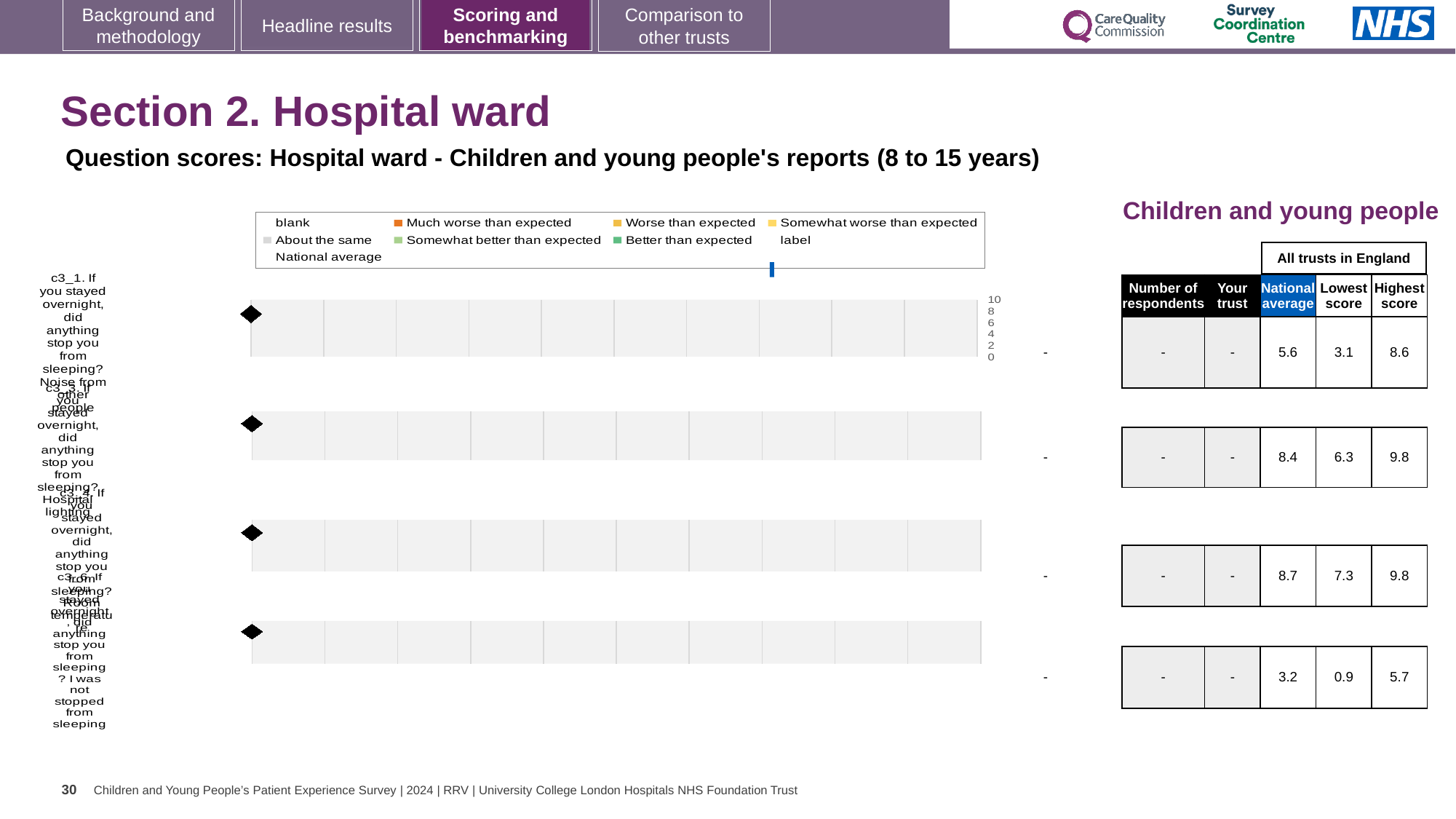
In the table beside the top chart (c3_1, noise from other people), what is the national average score? 5.6 What colour is used in the legend for 'Much worse than expected'? orange What kind of chart is used for the question scores on this slide? bar chart What is the highest tick value shown on the score axis of the charts? 10 How many entries does the legend above the charts list? 9 In the table beside the third chart (c3_4, room temperature), what is the national average score? 8.7 In the table beside the bottom chart (c3_6, I was not stopped from sleeping), what is the lowest score across all trusts in England? 0.9 How many separate question charts are shown on the slide? 4 In the table beside the second chart (c3_3, hospital lighting), what is the highest score across all trusts in England? 9.8